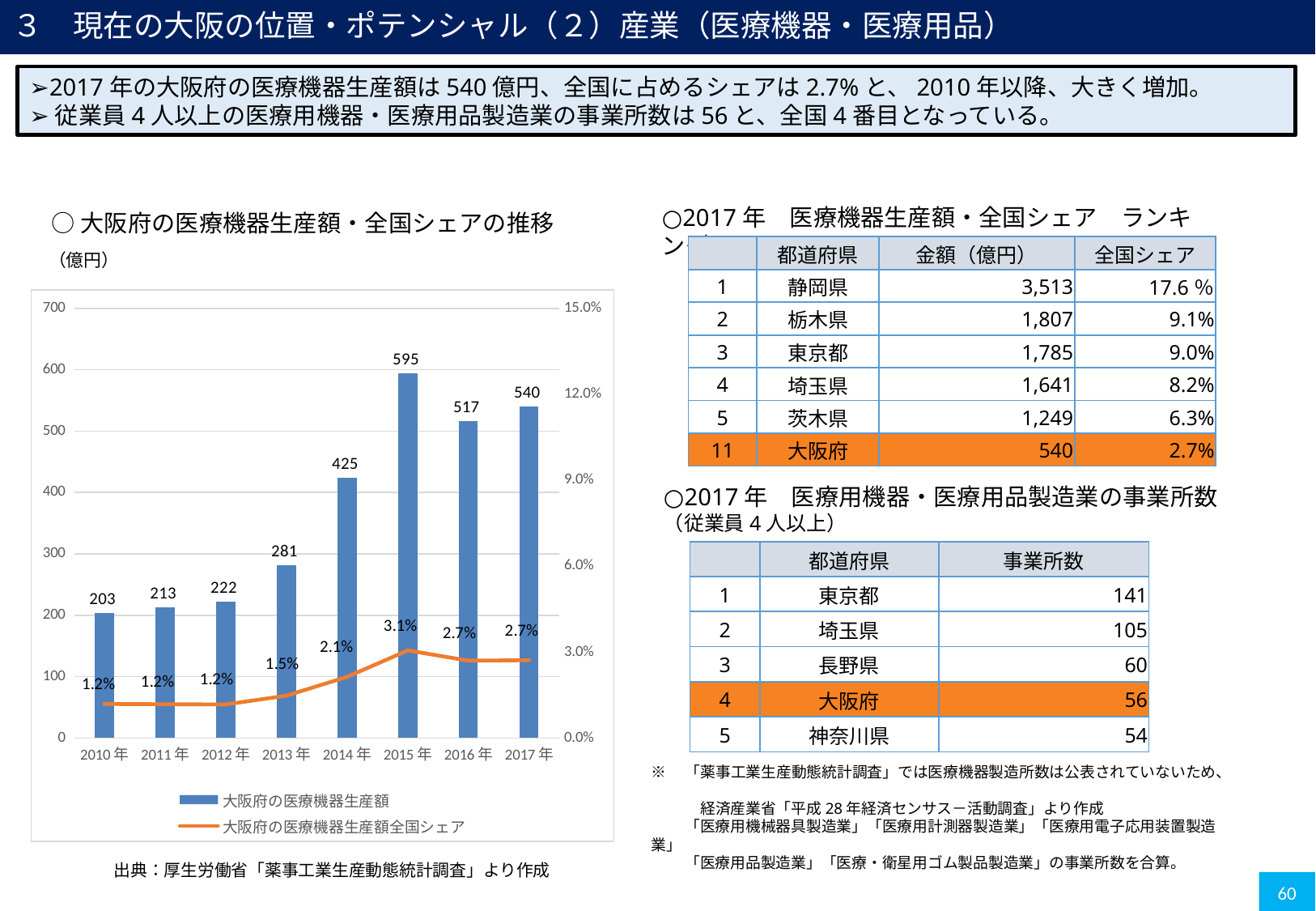
How many years are shown on the x axis of the chart? 8 How many series does the chart legend list? 2 Does the 大阪府の医療機器生産額 rise or fall from 2010年 to 2015年? Rise Which year has the lowest 大阪府の医療機器生産額? 2010年 What kind of chart is used to show 大阪府の医療機器生産額・全国シェアの推移? Combined bar and line chart What is the 大阪府の医療機器生産額全国シェア for 2015年? 3.1% Which is larger, the 大阪府の医療機器生産額 for 2016年 or for 2017年? 2017年 What is the value of 大阪府の医療機器生産額 for 2017年? 540 What is the value of 大阪府の医療機器生産額 for 2014年? 425 What is the difference in 大阪府の医療機器生産額 between 2015年 and 2016年? 78 What is the 大阪府の医療機器生産額全国シェア for 2013年? 1.5% Which year has the highest 大阪府の医療機器生産額? 2015年